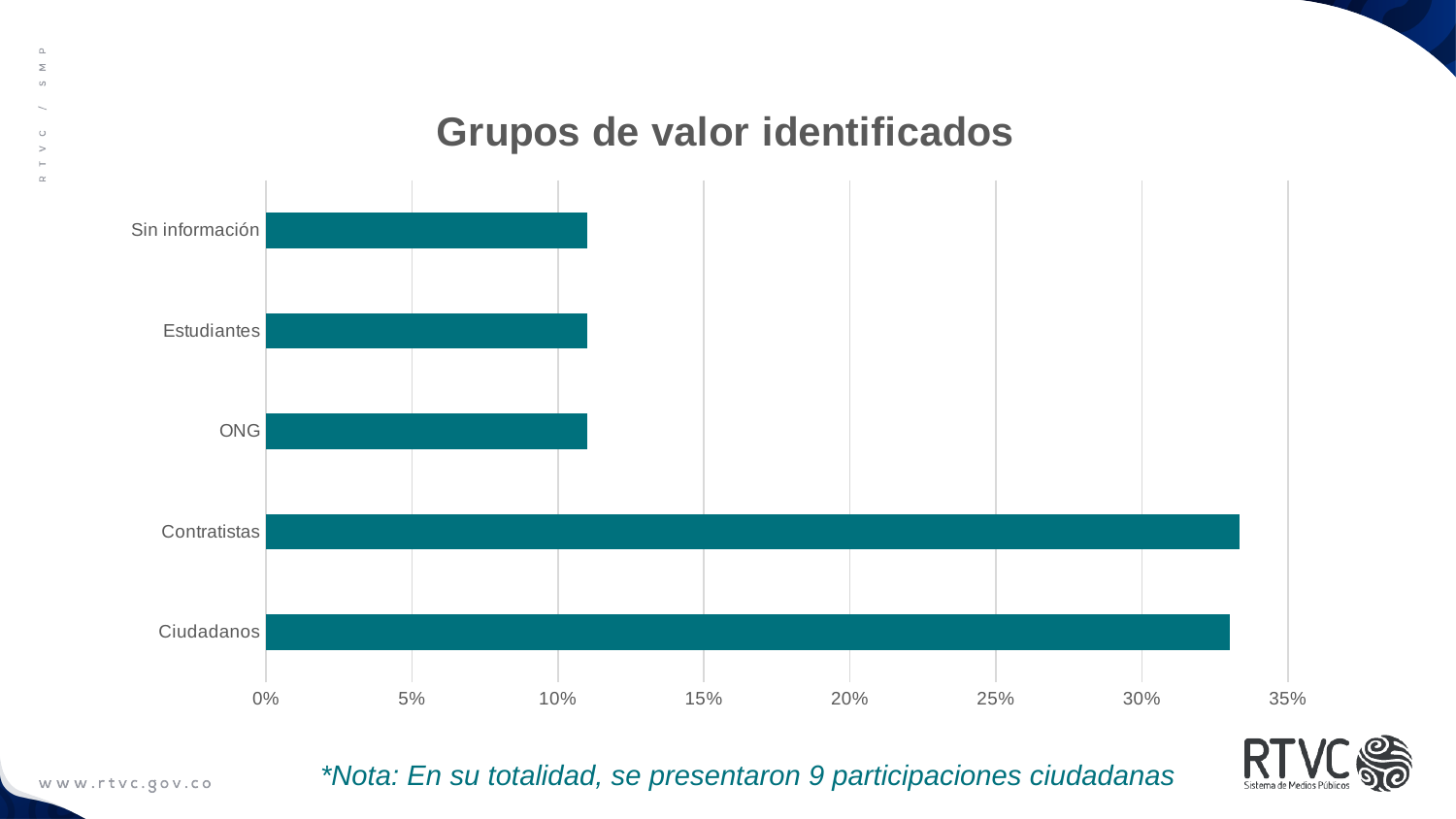
Is the value for Estudiantes greater or less than 20%? less Is the value for Contratistas greater or less than 30%? greater Is the value for ONG greater or less than 15%? less What is the title of the chart? Grupos de valor identificados How many categories are plotted in the chart? 5 Which has the larger value, Contratistas or ONG? Contratistas What kind of chart is shown on the slide? bar chart What is the highest value shown on the x axis of the chart? 35% Which has the larger value, Ciudadanos or Estudiantes? Ciudadanos